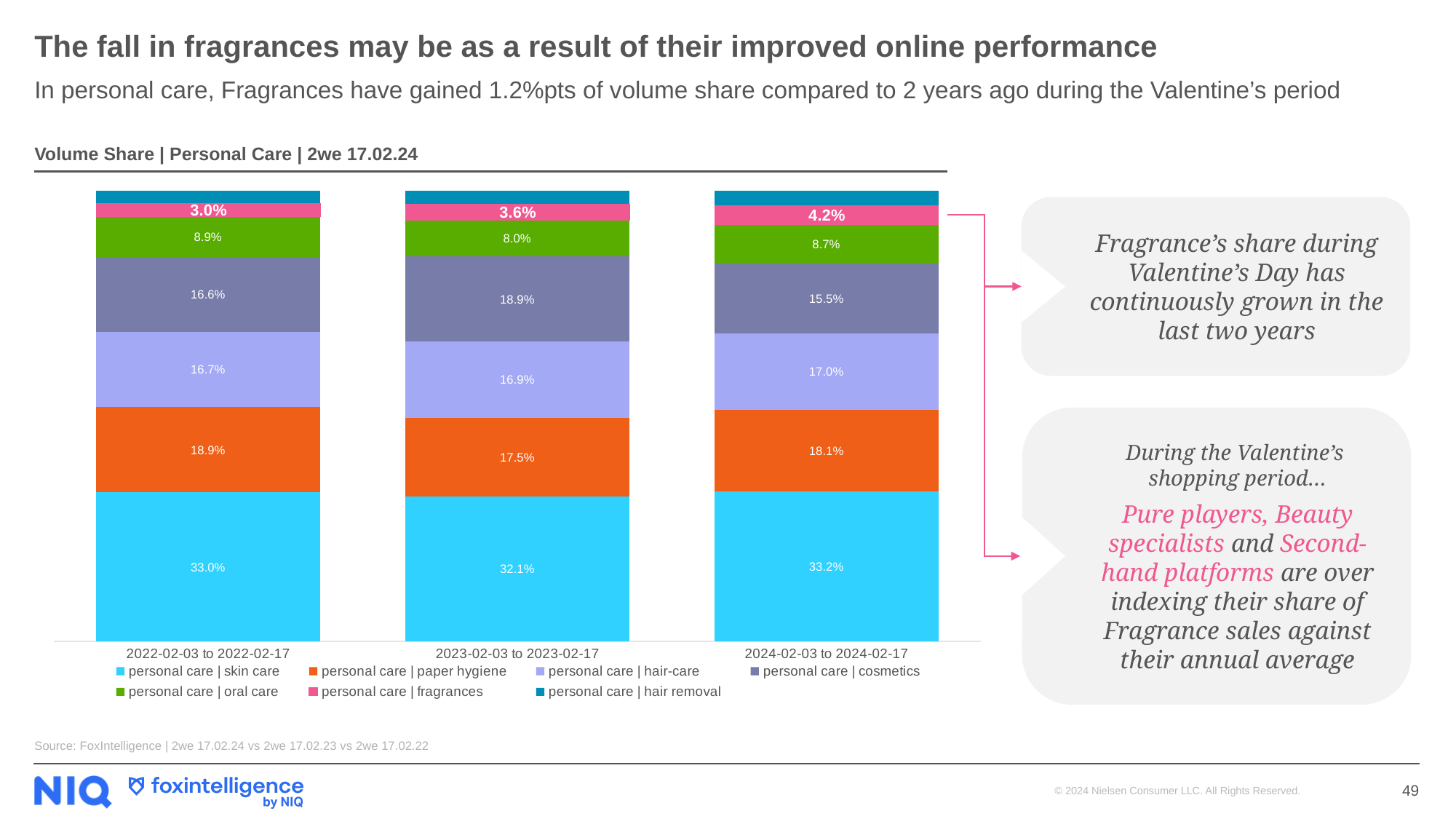
By how many percentage points did the fragrances share change from the 2022-02-03 to 2022-02-17 period to the 2024-02-03 to 2024-02-17 period? 1.2 percentage points What is the volume share of personal care | fragrances in the 2024-02-03 to 2024-02-17 period? 4.2% Which is larger in the 2023-02-03 to 2023-02-17 period: the share of personal care | cosmetics or personal care | paper hygiene? personal care | cosmetics How many series does the legend list? 7 How does the fragrances share change across the three periods shown? It rises What is the volume share of personal care | skin care in the 2023-02-03 to 2023-02-17 period? 32.1% How many periods (bars) are shown in the chart? 3 What type of chart is shown on the slide? Stacked bar chart Which category has the largest volume share in the 2024-02-03 to 2024-02-17 period? personal care | skin care In which period is the volume share of personal care | cosmetics highest? 2023-02-03 to 2023-02-17 What is the difference between the paper hygiene share in 2022-02-03 to 2022-02-17 and in 2023-02-03 to 2023-02-17? 1.4 percentage points What is the volume share of personal care | cosmetics in the 2022-02-03 to 2022-02-17 period? 16.6%